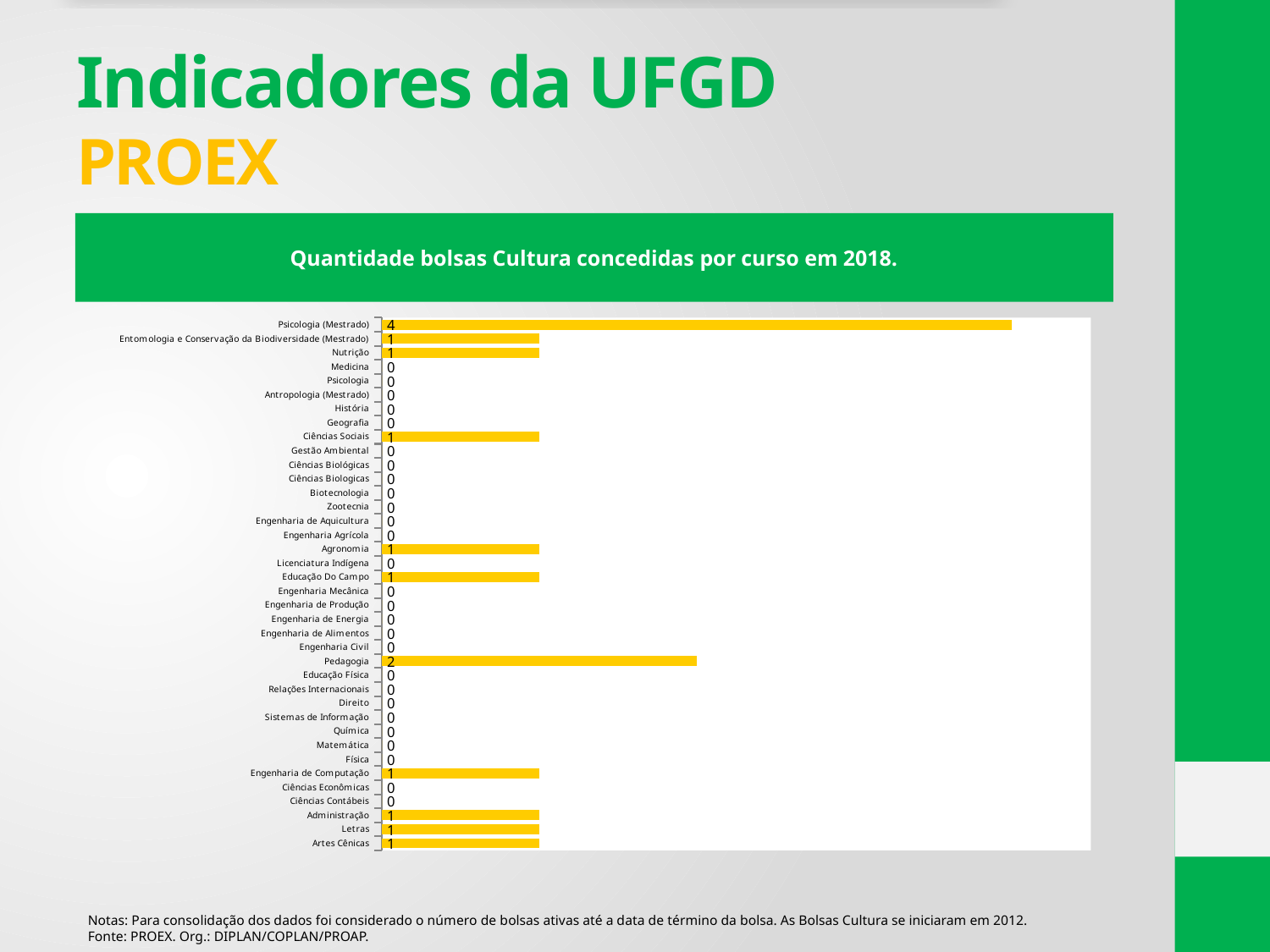
What colour are the bars in the chart? yellow What type of chart is shown on the slide? bar chart How many Cultura scholarships were granted to Pedagogia? 2 Which received more Cultura scholarships, Pedagogia or Agronomia? Pedagogia Which course received the highest number of Cultura scholarships? Psicologia (Mestrado) How many Cultura scholarships were granted to Medicina? 0 How many Cultura scholarships were granted to Psicologia (Mestrado)? 4 What is the title of the chart? Quantidade bolsas Cultura concedidas por curso em 2018. How many courses received exactly 1 Cultura scholarship? 9 How many Cultura scholarships were granted to Nutrição? 1 What is the difference between the number of scholarships for Psicologia (Mestrado) and Pedagogia? 2 How many courses are listed in the chart? 38